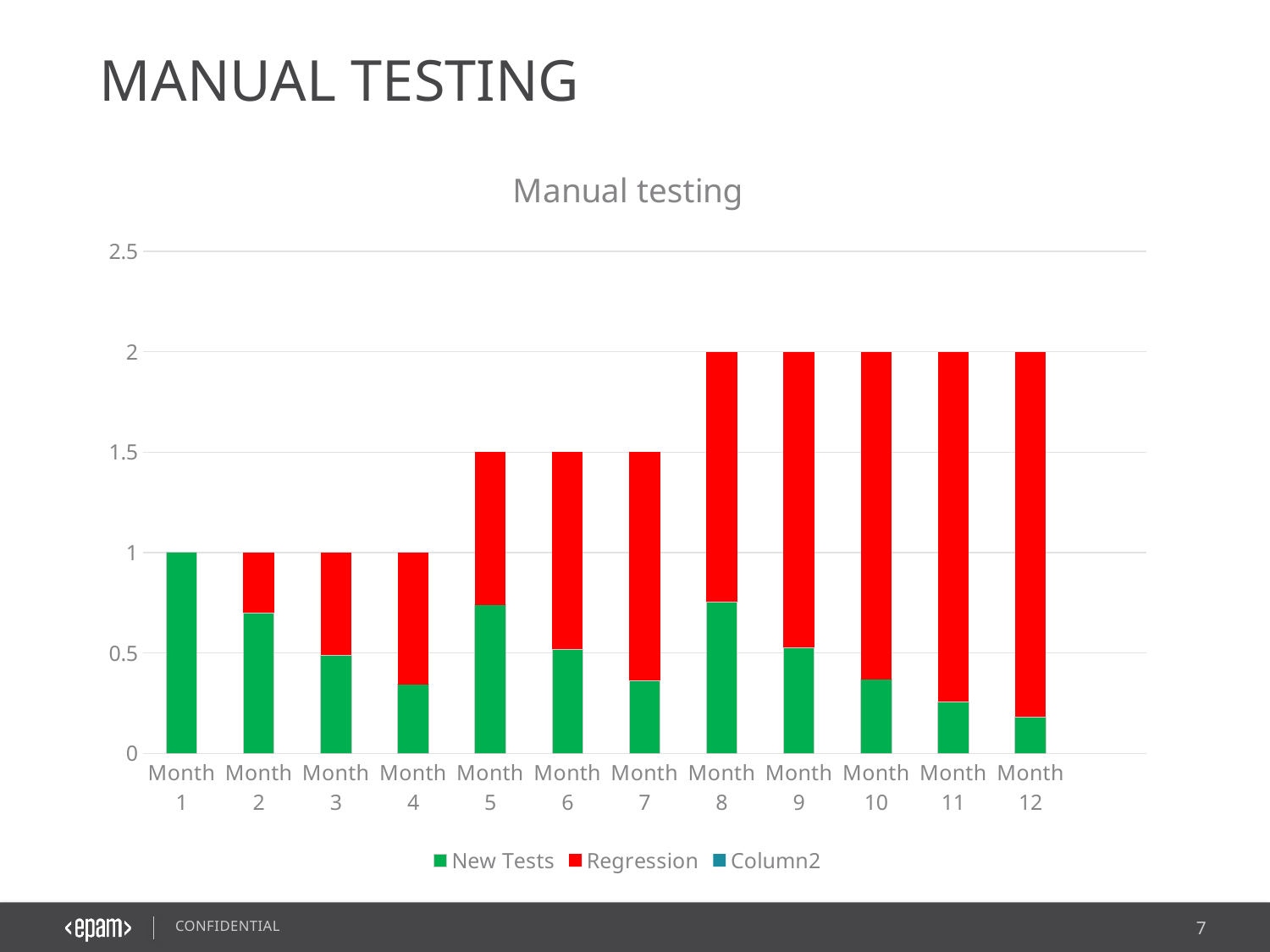
Do the total bar heights rise or fall from Month 1 to Month 12? Rise What is the New Tests value for Month 1? 1 What is the total height of the stacked bar for Month 1? 1 What is the total height of the stacked bar for Month 6? 1.5 What is the title of the chart? Manual testing Is the New Tests value for Month 4 greater or less than 0.5? less How many series does the legend list? 3 Is the New Tests value for Month 8 greater or less than 0.5? greater What kind of chart is shown on the slide? Stacked bar chart Which month has the highest New Tests value? Month 1 How many months are shown on the x axis? 12 What is the total height of the stacked bar for Month 10? 2